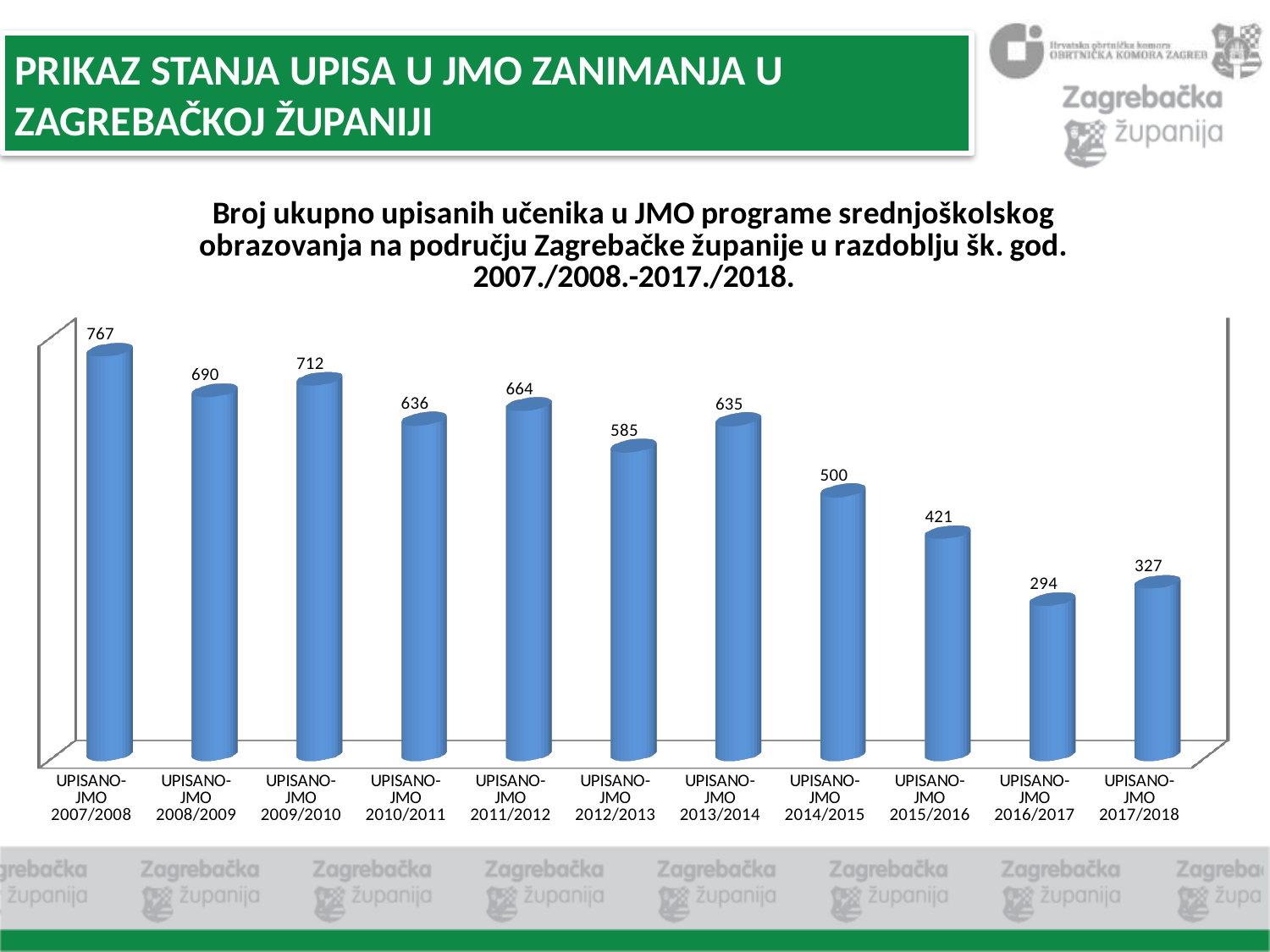
What kind of chart is shown on the slide? Bar chart Do the values generally rise or fall from 2007/2008 to 2017/2018? Fall What is the value for UPISANO-JMO 2017/2018? 327 How many categories are shown in the chart? 11 What is the value for UPISANO-JMO 2007/2008? 767 Which category has the highest value? UPISANO-JMO 2007/2008 What is the difference between the values for UPISANO-JMO 2014/2015 and UPISANO-JMO 2015/2016? 79 Which is larger, the value for UPISANO-JMO 2008/2009 or UPISANO-JMO 2009/2010? UPISANO-JMO 2009/2010 Which category has the lowest value? UPISANO-JMO 2016/2017 What colour are the bars in the chart? Blue What is the difference between the values for UPISANO-JMO 2007/2008 and UPISANO-JMO 2017/2018? 440 What is the value for UPISANO-JMO 2013/2014? 635